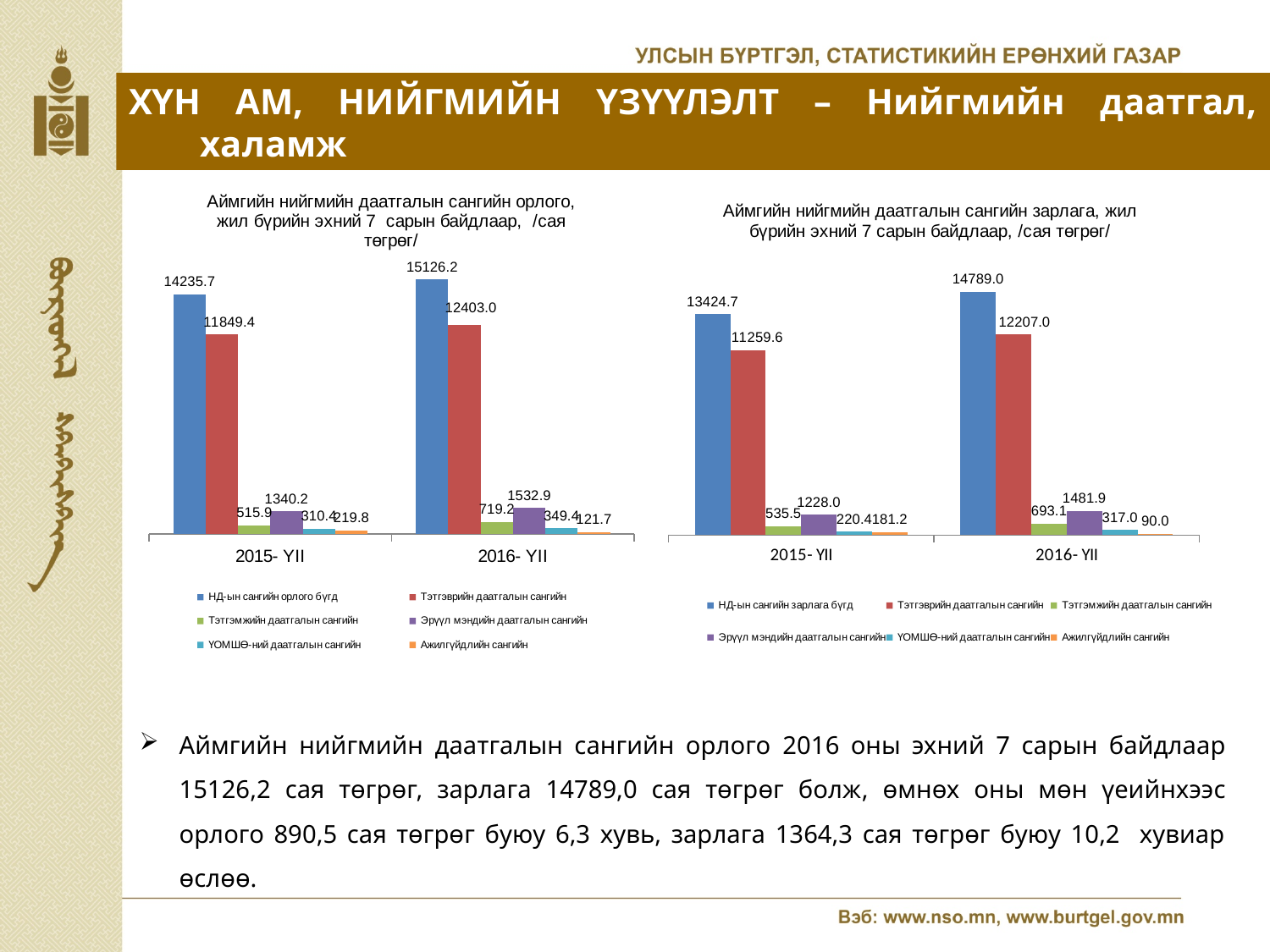
How many categories are shown on the x axis of the right chart (зарлага)? 2 In the left chart (орлого), what is the value of Эрүүл мэндийн даатгалын сангийн for 2015-YII? 1340.2 In the right chart (зарлага), which is larger for 2016-YII: Тэтгэмжийн даатгалын сангийн or Эрүүл мэндийн даатгалын сангийн? Эрүүл мэндийн даатгалын сангийн In the right chart (зарлага), what is the value of Ажилгүйдлийн сангийн for 2016-YII? 90.0 In the left chart (орлого), which series has the lowest value for 2016-YII? Ажилгүйдлийн сангийн In the right chart (Аймгийн нийгмийн даатгалын сангийн зарлага), what is the value of НД-ын сангийн зарлага бүгд for 2015-YII? 13424.7 In the right chart (зарлага), what is the difference between НД-ын сангийн зарлага бүгд in 2016-YII and in 2015-YII? 1364.3 In the right chart (зарлага), does the value of Тэтгэврийн даатгалын сангийн rise or fall from 2015-YII to 2016-YII? Rise In the left chart (Аймгийн нийгмийн даатгалын сангийн орлого), what is the value of НД-ын сангийн орлого бүгд for 2016-YII? 15126.2 What type of chart is the left chart (орлого)? Bar chart In the left chart (орлого), what is the difference between НД-ын сангийн орлого бүгд in 2016-YII and in 2015-YII? 890.5 How many series does the legend of the left chart (орлого) list? 6